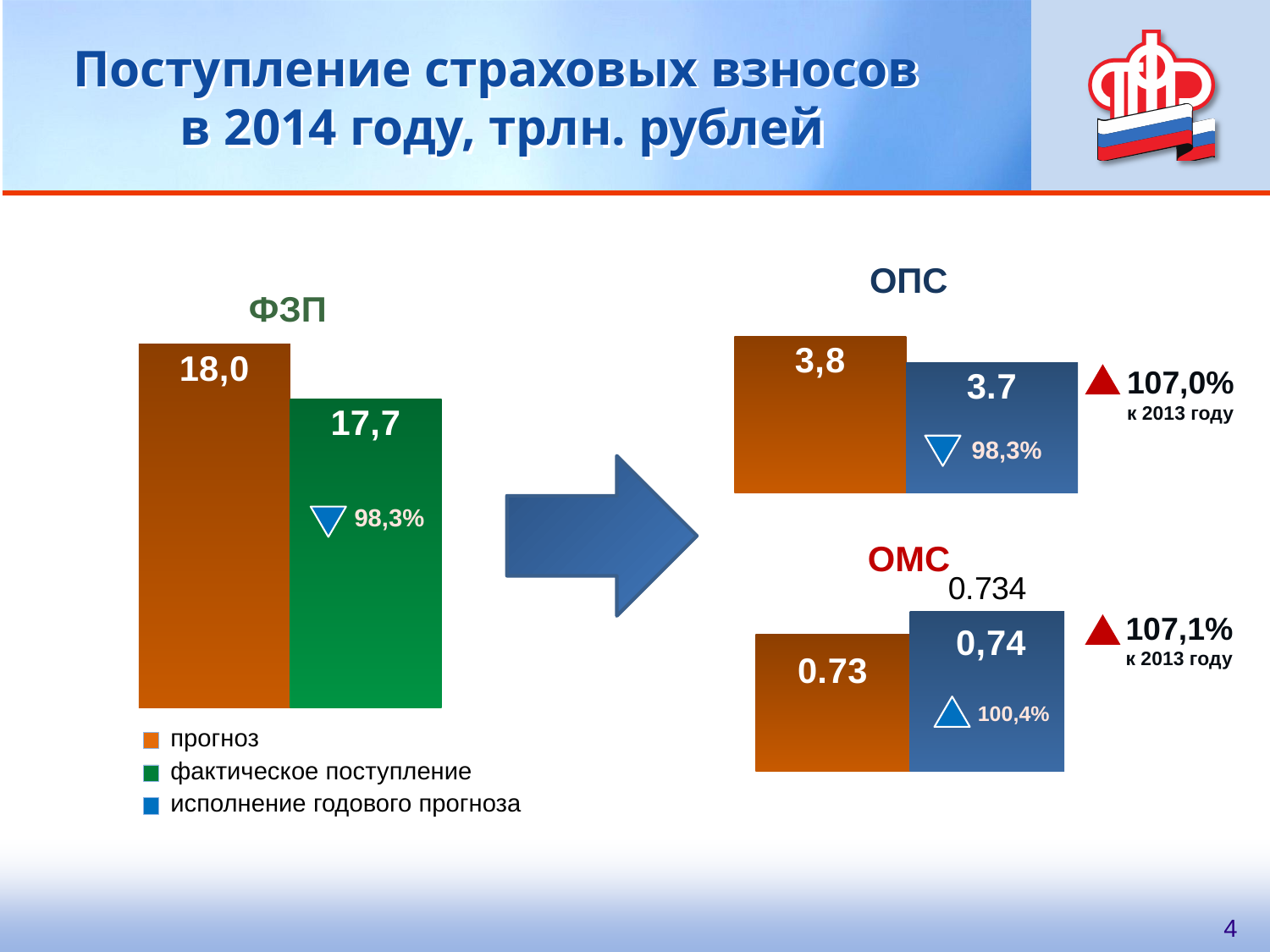
In the ОМС chart, what is the actual receipt value? 0,74 In the ОПС chart, what is the forecast value? 3,8 In the ФЗП chart, what is the difference between the forecast and the actual receipt? 0,3 In the ФЗП chart, what is the forecast (прогноз) value? 18,0 In the ОПС chart, what is the actual receipt value? 3.7 In the ОМС chart, what percentage of the annual forecast was fulfilled? 100,4% In the ФЗП chart, which is larger: the forecast or the actual receipt? the forecast (прогноз) How many entries does the legend on the slide list? 3 In the ФЗП chart, what is the actual receipt (фактическое поступление) value? 17,7 In the ФЗП chart, what percentage of the annual forecast was fulfilled? 98,3% In the ОМС chart, which is larger: the forecast or the actual receipt? the actual receipt (фактическое поступление) In the ОПС chart, what is the growth relative to 2013 (к 2013 году)? 107,0%